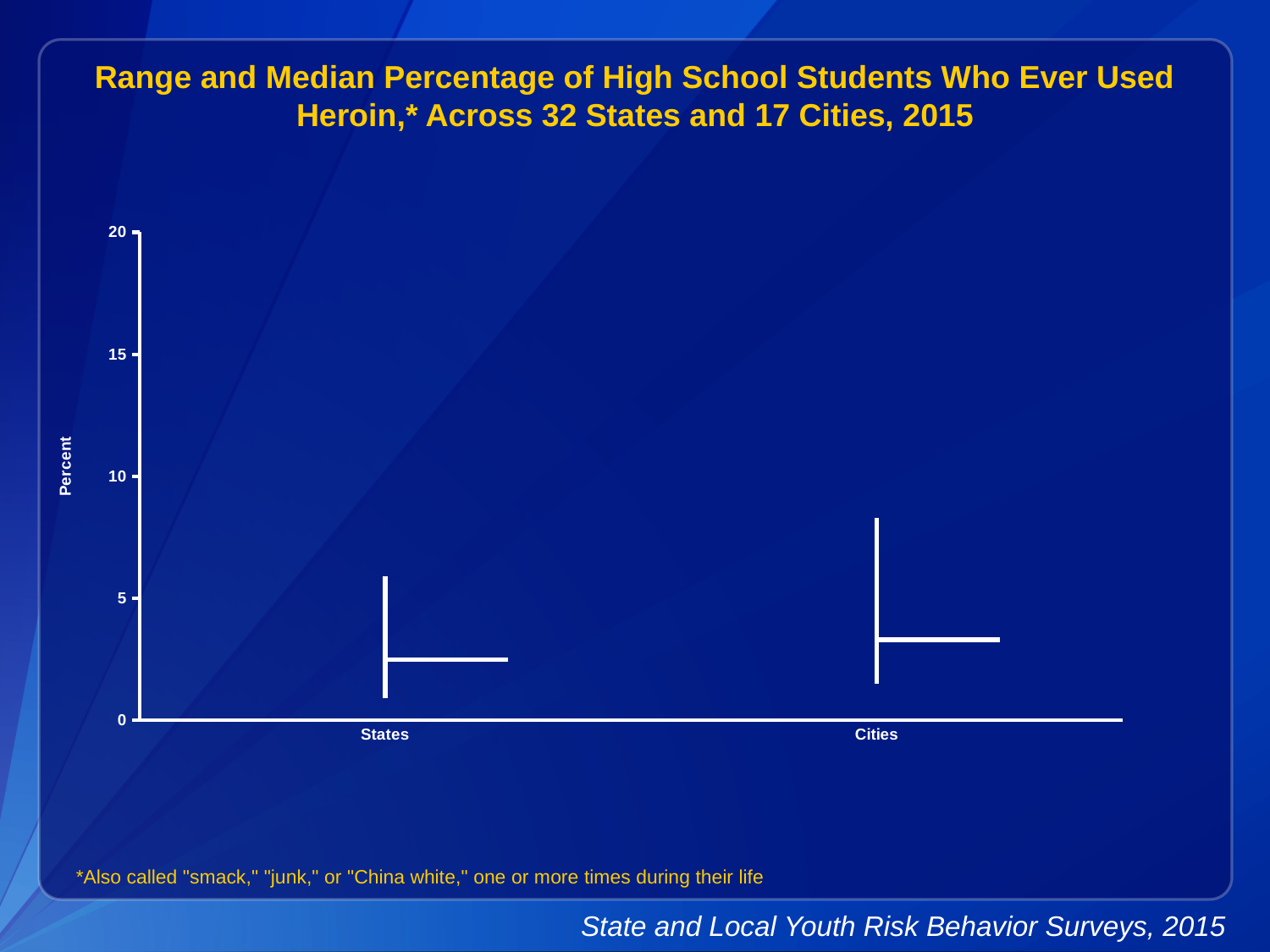
Is the median value for States greater or less than 5? less Which category has the higher top of its range, States or Cities? Cities Is the top of the range for Cities greater or less than 10? less Is the top of the range for States greater or less than 10? less What is the title of the chart? Range and Median Percentage of High School Students Who Ever Used Heroin,* Across 32 States and 17 Cities, 2015 What is the highest value shown on the vertical axis? 20 What is the label on the vertical axis of the chart? Percent Which category has the lower top of its range? States How many categories are shown on the x axis of the chart? 2